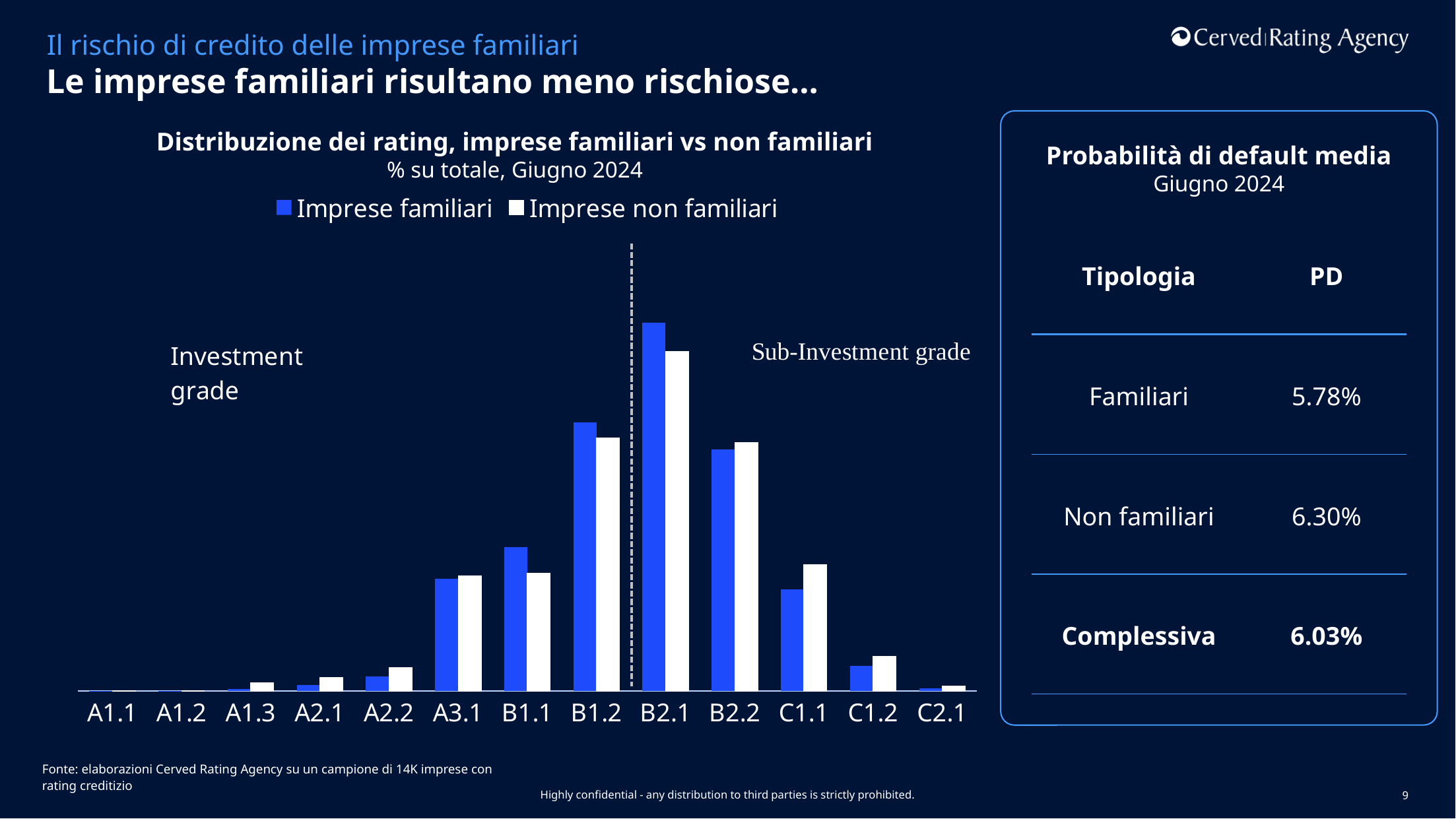
For rating C1.2, which series has the larger value, Imprese familiari or Imprese non familiari? Imprese non familiari For Imprese familiari, which is larger, the value for B1.2 or the value for B2.2? B1.2 Which rating category has the highest value for Imprese familiari? B2.1 How many series does the chart legend list? 2 Which colour represents Imprese non familiari in the chart? white What kind of chart is shown on the slide? bar chart For rating C1.1, which series has the larger value, Imprese familiari or Imprese non familiari? Imprese non familiari How many rating categories are shown on the x axis of the chart? 13 Which rating category has the highest value for Imprese non familiari? B2.1 What is the title of the chart? Distribuzione dei rating, imprese familiari vs non familiari